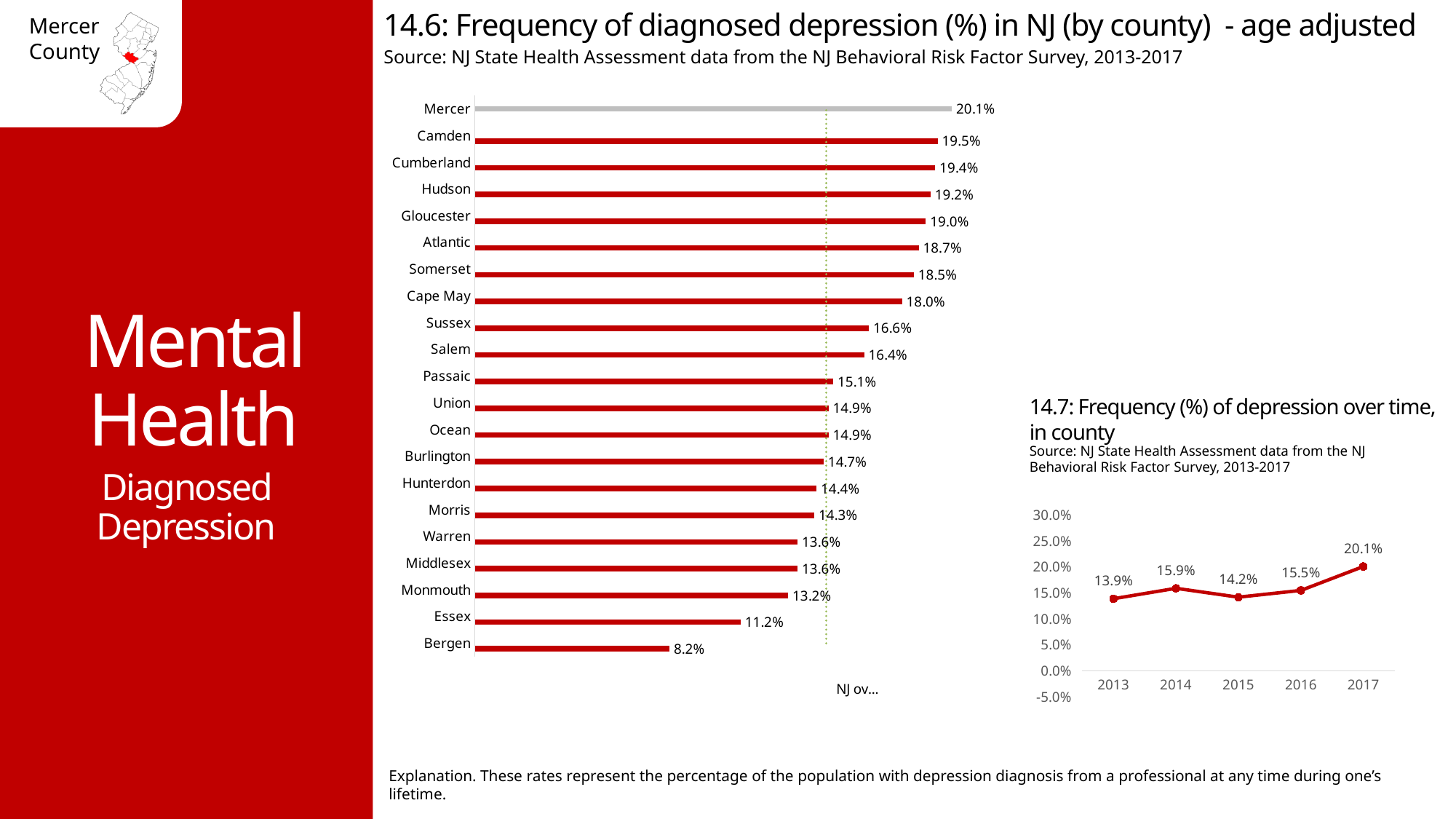
In the chart '14.7: Frequency (%) of depression over time, in county', what is the value for 2014? 15.9% In the chart '14.6: Frequency of diagnosed depression (%) in NJ (by county) - age adjusted', which is larger, the value for Sussex or the value for Passaic? Sussex In the chart '14.6: Frequency of diagnosed depression (%) in NJ (by county) - age adjusted', what is the value for Mercer? 20.1% In the chart '14.7: Frequency (%) of depression over time, in county', which year has the highest value? 2017 In the chart '14.6: Frequency of diagnosed depression (%) in NJ (by county) - age adjusted', what is the difference between the values for Mercer and Bergen? 11.9% In the chart '14.7: Frequency (%) of depression over time, in county', what is the difference between the values for 2017 and 2013? 6.2% What kind of chart is '14.7: Frequency (%) of depression over time, in county'? Line chart In the chart '14.6: Frequency of diagnosed depression (%) in NJ (by county) - age adjusted', which county has the highest value? Mercer In the chart '14.6: Frequency of diagnosed depression (%) in NJ (by county) - age adjusted', which county has the lowest value? Bergen In the chart '14.6: Frequency of diagnosed depression (%) in NJ (by county) - age adjusted', what is the value for Hudson? 19.2% In the chart '14.6: Frequency of diagnosed depression (%) in NJ (by county) - age adjusted', how many counties are plotted? 21 What kind of chart is '14.6: Frequency of diagnosed depression (%) in NJ (by county) - age adjusted'? Bar chart